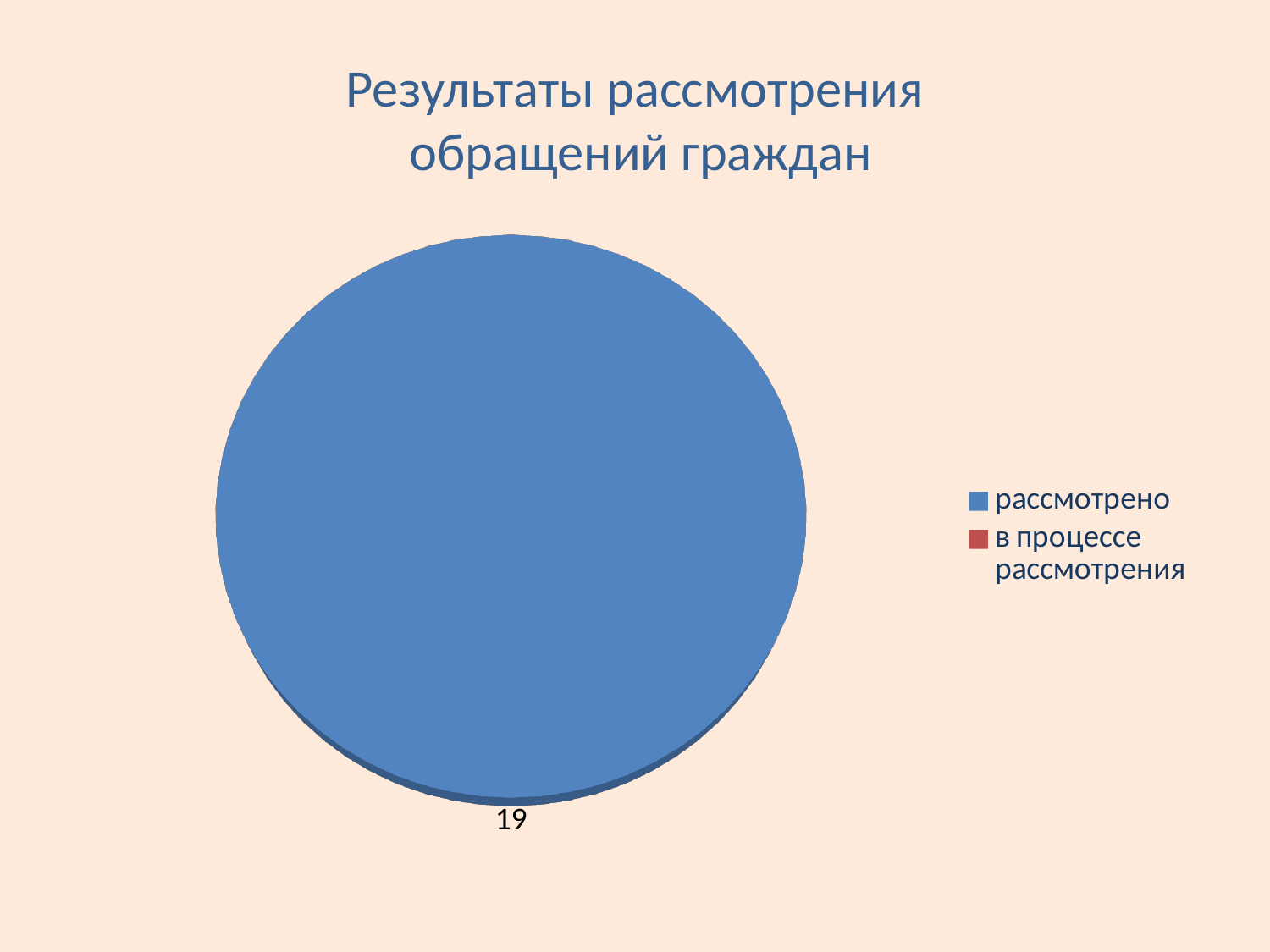
What colour represents the category "рассмотрено" in the legend? blue Is the value for "рассмотрено" greater or less than 10? greater What is the title of the chart? Результаты рассмотрения обращений граждан What value is printed on the pie for the category "рассмотрено"? 19 Which category has the largest slice of the pie? рассмотрено How many entries does the legend list? 2 What kind of chart is shown on the slide? pie chart Which is larger, the slice for "рассмотрено" or the slice for "в процессе рассмотрения"? рассмотрено Which category has the smallest slice of the pie? в процессе рассмотрения